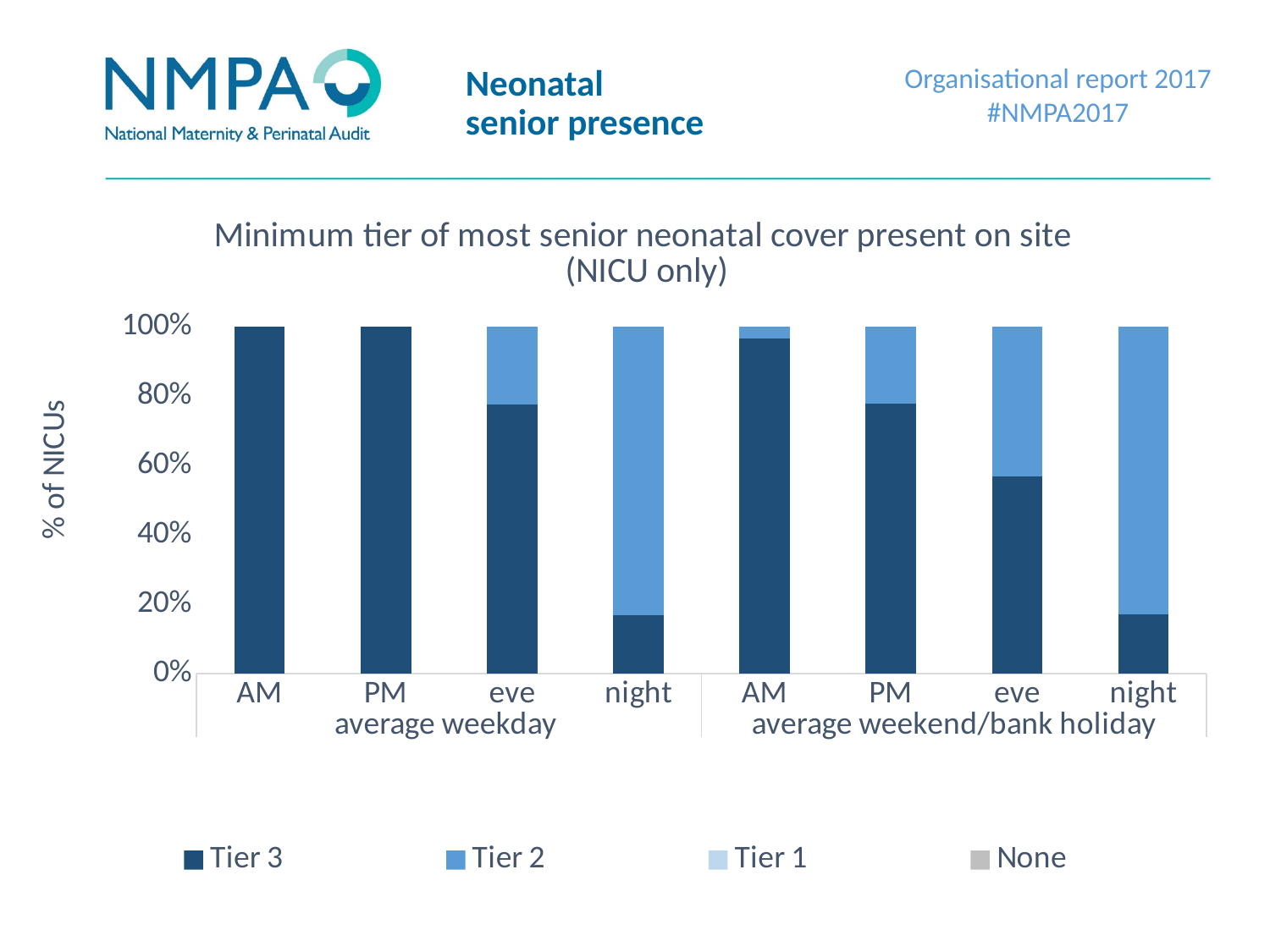
What kind of chart is shown on the slide? Stacked bar chart Is the Tier 3 value for AM on an average weekend/bank holiday greater or less than 80%? greater How many time-period categories are plotted along the x axis? 8 Which is larger: the Tier 3 share for eve on an average weekday or the Tier 3 share for eve on an average weekend/bank holiday? eve on an average weekday What is the title of the chart? Minimum tier of most senior neonatal cover present on site (NICU only) How many series does the legend list? 4 Is the Tier 3 value for night on an average weekday greater or less than 20%? less Which time period on an average weekend/bank holiday has the lowest Tier 3 share? night What is the Tier 3 value for AM on an average weekday? 100% Within the average weekday group, does the Tier 3 share rise or fall from AM to night? fall What is the Tier 3 value for PM on an average weekday? 100% Is the Tier 3 value for eve on an average weekend/bank holiday greater or less than 40%? greater